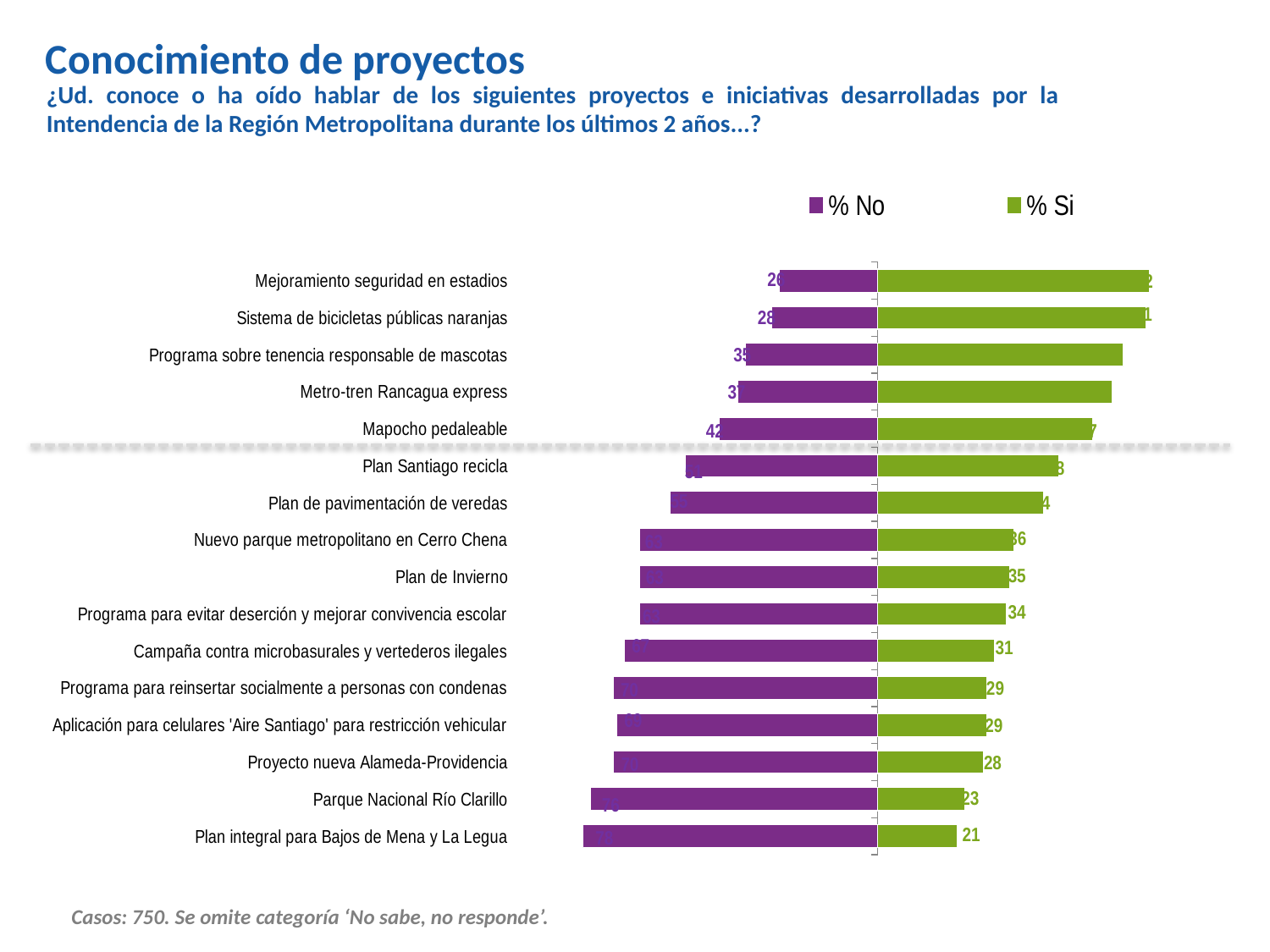
What is the % No value for 'Mapocho pedaleable'? 42 How many series does the legend list? 2 How many projects (categories) are plotted in the chart? 16 Which colour represents the '% Si' series in the chart? green What is the % No value for 'Mejoramiento seguridad en estadios'? 26 What is the difference between the % Si values for 'Nuevo parque metropolitano en Cerro Chena' and 'Plan integral para Bajos de Mena y La Legua'? 15 Which project has the highest % Si value? Mejoramiento seguridad en estadios What is the % Si value for 'Nuevo parque metropolitano en Cerro Chena'? 36 Which project has the lowest % Si value? Plan integral para Bajos de Mena y La Legua What is the % Si value for 'Plan integral para Bajos de Mena y La Legua'? 21 What is the % Si value for 'Parque Nacional Río Clarillo'? 23 What kind of chart is shown on the slide? bar chart